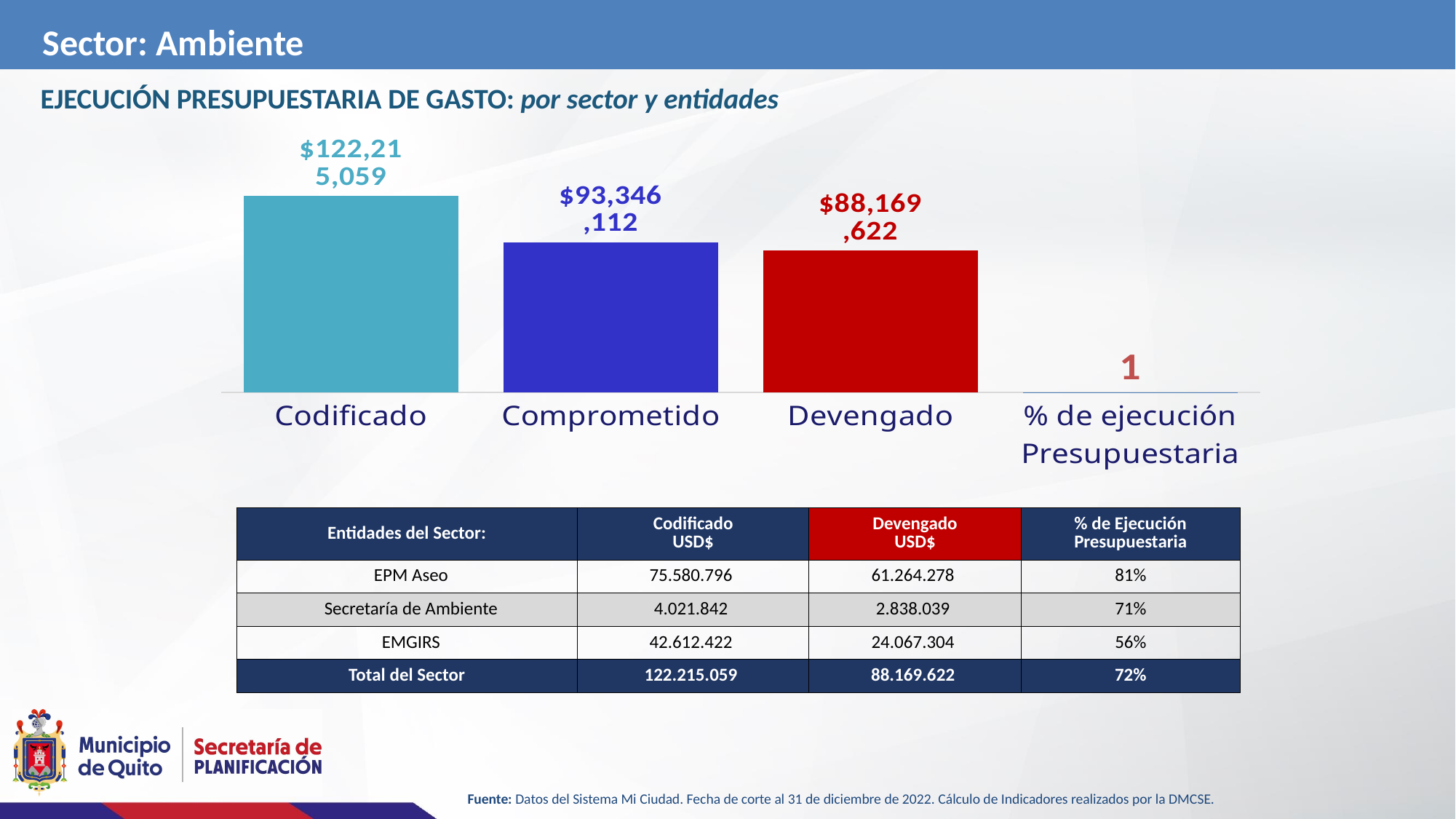
How many categories are shown on the x axis of the bar chart? 4 Which is larger in the bar chart, Comprometido or Devengado? Comprometido What is the value shown for Codificado in the bar chart? $122,215,059 What is the difference between the Comprometido and Devengado values in the bar chart? $5,176,490 What colour is the Devengado bar in the chart? Red What is the difference between the Codificado and Comprometido values in the bar chart? $28,868,947 What is the value shown for Devengado in the bar chart? $88,169,622 What kind of chart is shown on the slide? Bar chart What value is printed for % de ejecución Presupuestaria in the bar chart? 1 Which category has the highest value in the bar chart? Codificado Which category has the lowest value in the bar chart? % de ejecución Presupuestaria What is the value shown for Comprometido in the bar chart? $93,346,112